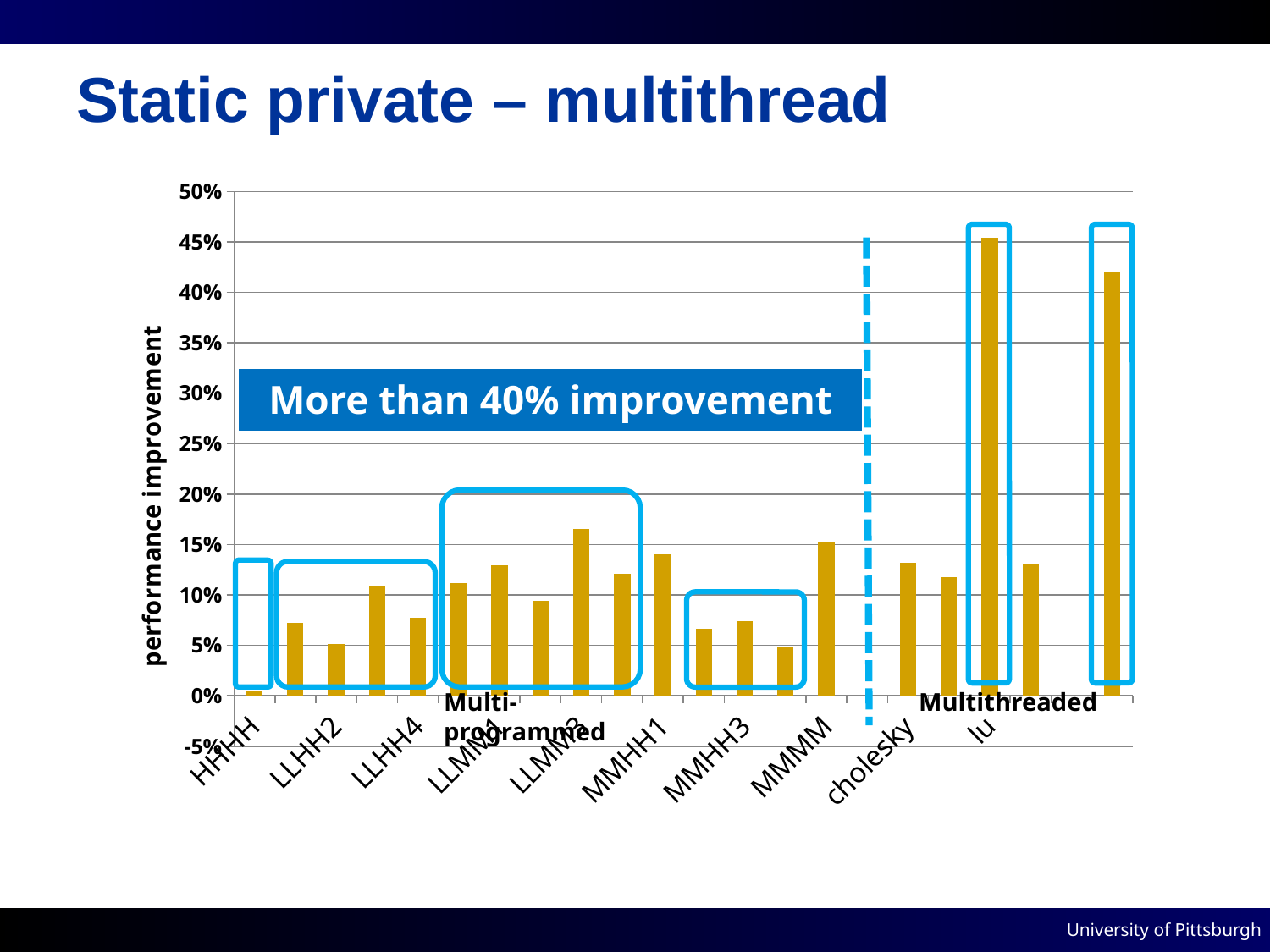
Which has the larger performance improvement, HHHH or MMMM? MMMM Is the value for MMHH3 greater or less than 10%? less Is the value for LLMM3 greater or less than 15%? greater Is the value for HHHH greater or less than 5%? less What is the label of the vertical axis? performance improvement Which has the larger performance improvement, lu or cholesky? lu What does the annotation box on the chart say? More than 40% improvement Which labeled category has the lowest performance improvement? HHHH What kind of chart is shown on the slide? bar chart How many bars exceed 40% performance improvement? 2